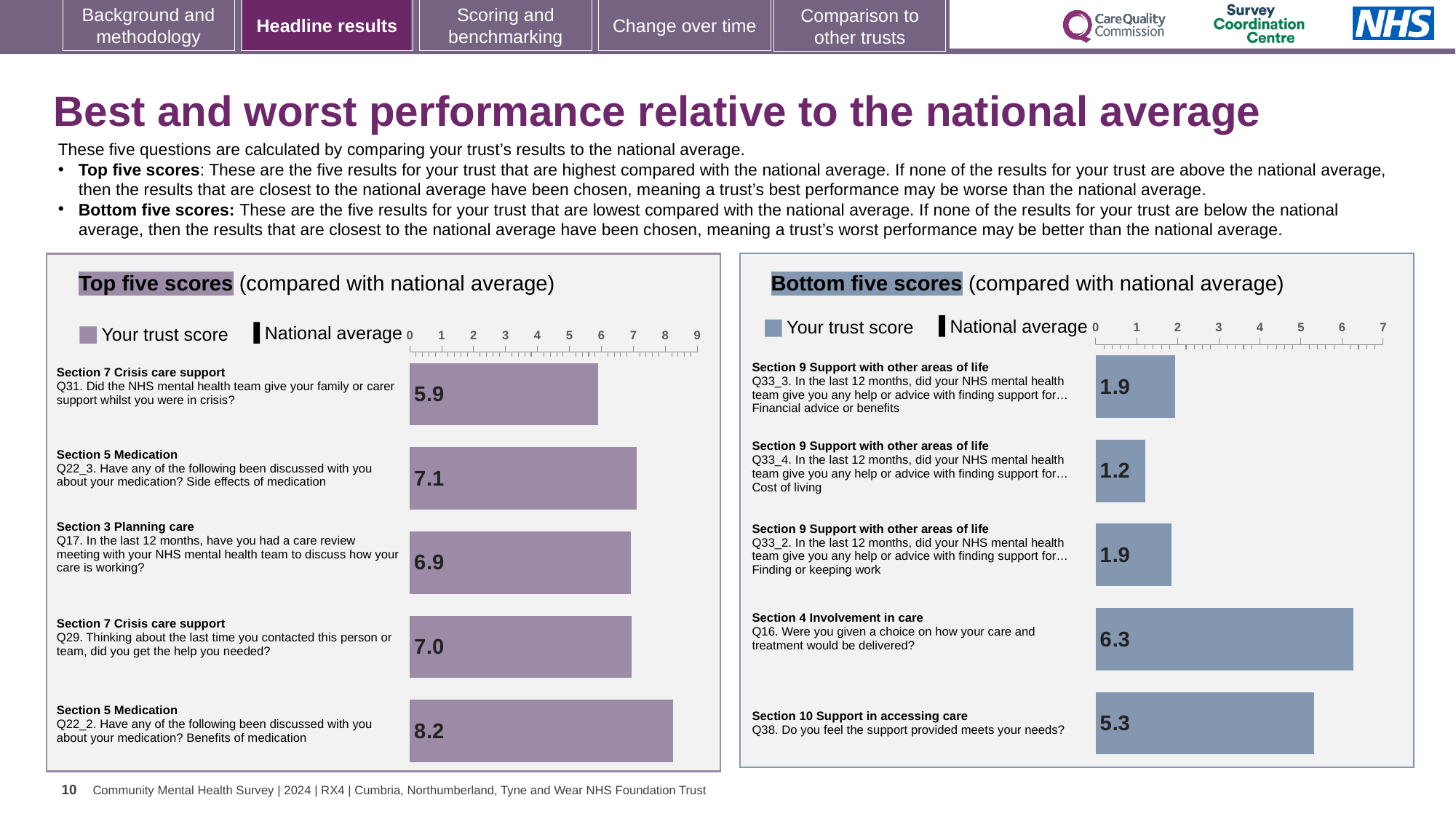
In the Bottom five scores chart, what is the trust score for Q33_4 (help with cost of living)? 1.2 In the Bottom five scores chart, what is the trust score for Q16 (choice on how care and treatment would be delivered)? 6.3 In the Top five scores chart, which question has the lowest trust score? Q31 In the Top five scores chart, what is the trust score for Q22_2 (benefits of medication discussed)? 8.2 In the Bottom five scores chart, which is larger, the trust score for Q16 or for Q38? Q16 What type of chart is the Top five scores chart? Bar chart In the Bottom five scores chart, which question has the lowest trust score? Q33_4 How many questions are shown in the Bottom five scores chart? 5 In the Top five scores chart, what is the difference between the trust scores for Q22_2 and Q31? 2.3 In the Top five scores chart, what is the trust score for Q31 (family or carer support whilst in crisis)? 5.9 In the Bottom five scores chart, what is the difference between the trust scores for Q16 and Q38? 1.0 In the Top five scores chart, which question has the highest trust score? Q22_2